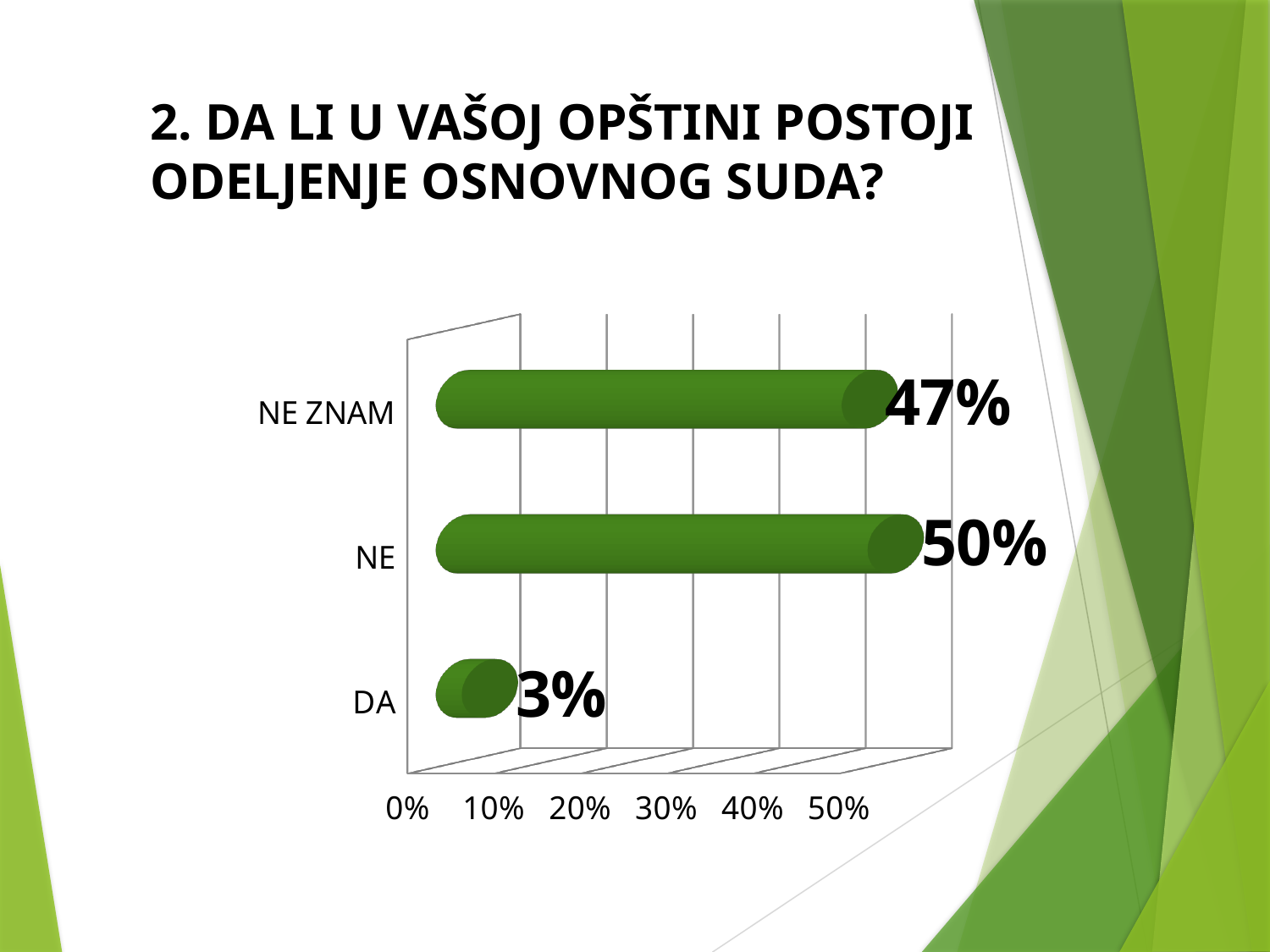
Is the value for NE ZNAM greater or less than 40%? greater What is the difference between the values for NE ZNAM and DA? 44% What is the difference between the values for NE and NE ZNAM? 3% What is the value for DA? 3% How many categories are shown in the chart? 3 What is the value for NE? 50% What is the title of the slide above the chart? 2. DA LI U VAŠOJ OPŠTINI POSTOJI ODELJENJE OSNOVNOG SUDA? Which is larger, the value for NE ZNAM or the value for DA? NE ZNAM What is the value for NE ZNAM? 47% What kind of chart is shown on the slide? bar chart Which category has the highest value? NE Which category has the lowest value? DA